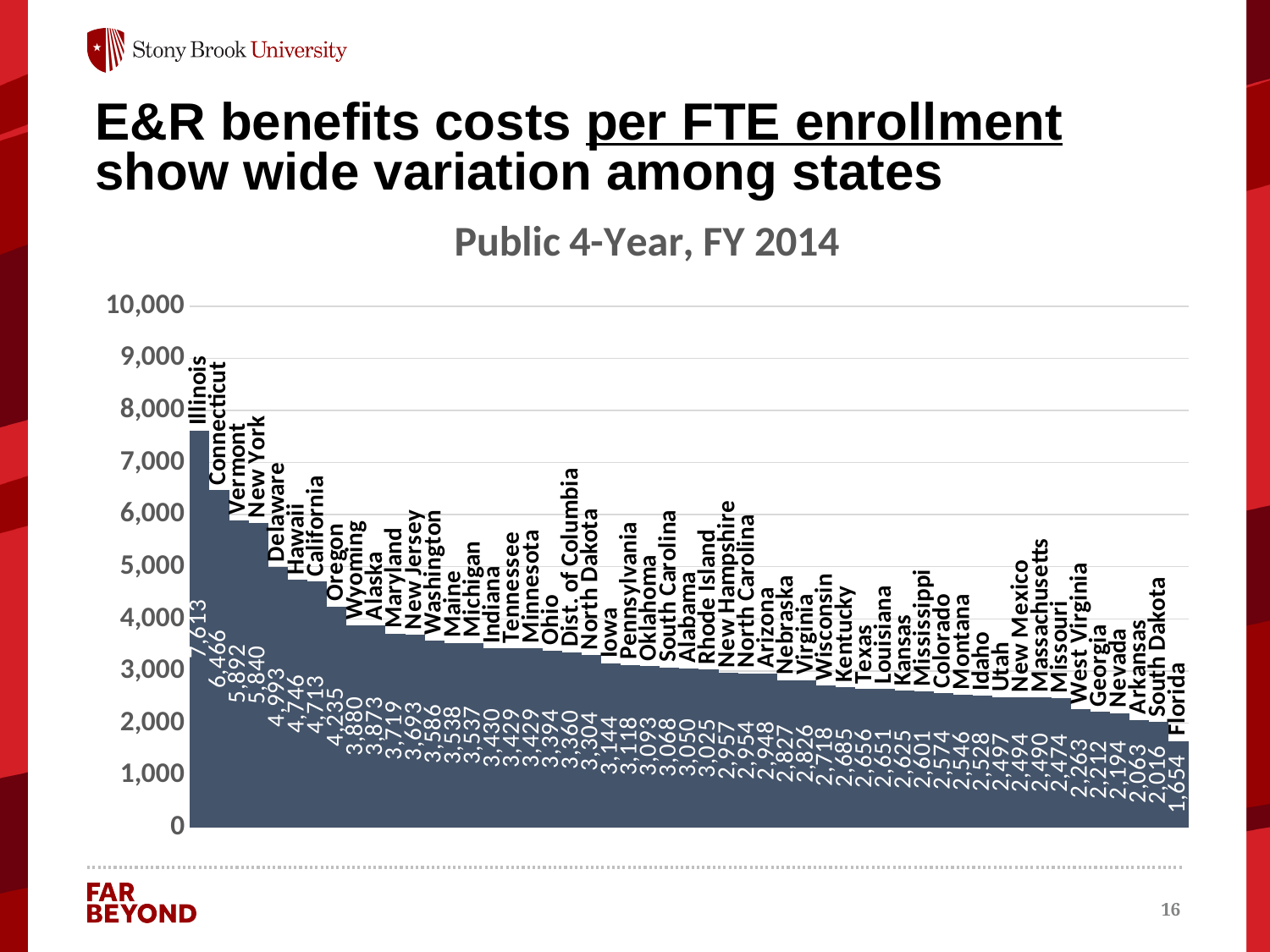
What is the difference between the values for Illinois and Connecticut? 1,147 What is the value for Texas? 2,656 Do the values rise or fall from left to right along the x axis? fall What is the value for Illinois? 7,613 Is the value for Oregon greater or less than 4,000? greater What is the value for Dist. of Columbia? 3,360 Which state has the lowest value? Florida What kind of chart is shown on the slide? bar chart Which has the larger value, Vermont or New York? Vermont What is the value for Florida? 1,654 Which state has the highest value? Illinois What is the title shown above the chart? Public 4-Year, FY 2014